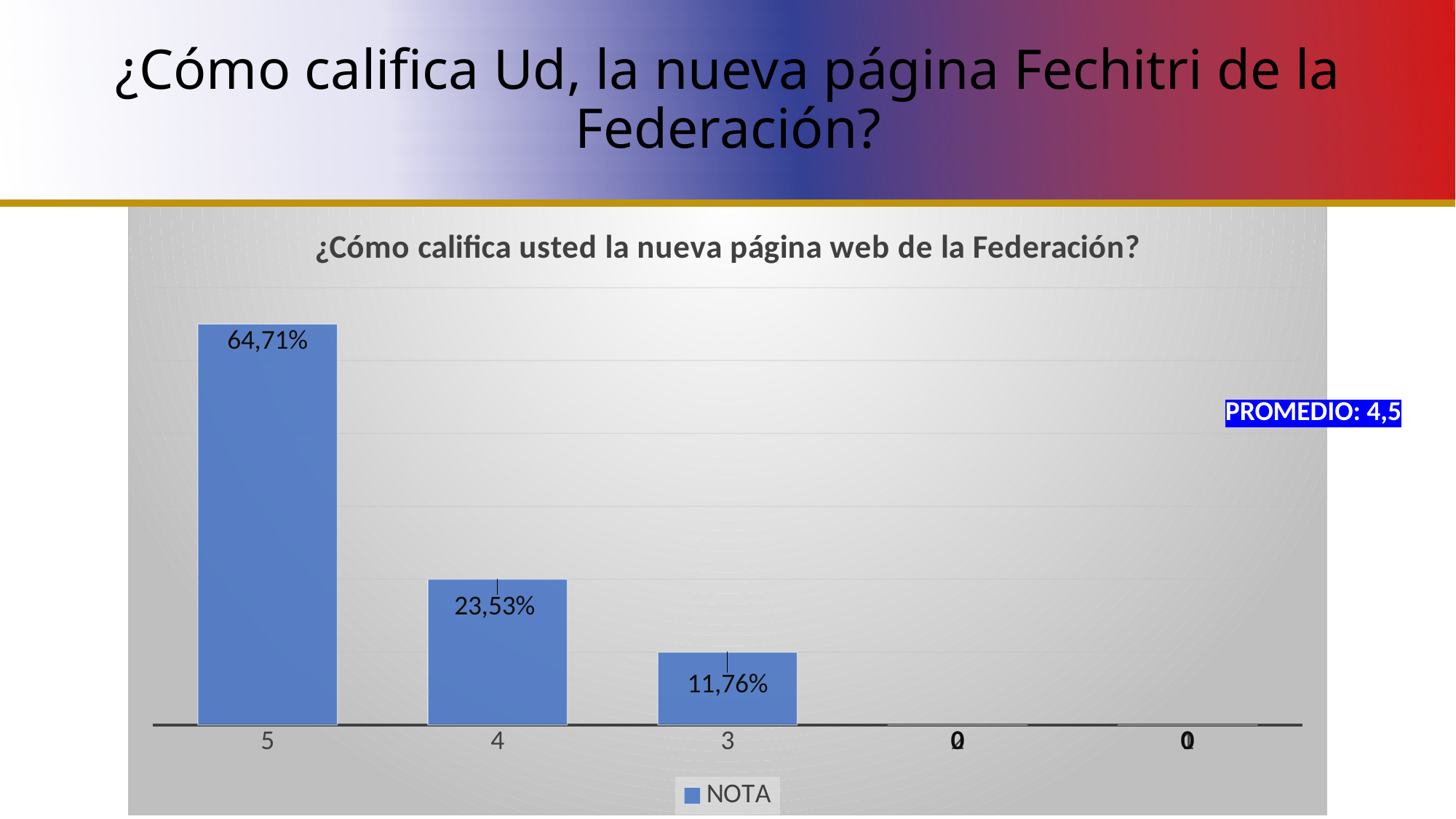
What percentage of respondents gave a rating of 4? 23,53% Which is larger, the percentage for rating 4 or for rating 3? rating 4 What kind of chart is shown on the slide? bar chart What is the difference between the percentages for rating 4 and rating 3? 11,77% Which rating category has the highest percentage? 5 What is the difference between the percentages for rating 5 and rating 4? 41,18% How many series does the legend list? 1 Do the bar values rise or fall moving from left to right along the x axis? fall How many rating categories are shown on the x axis? 5 What percentage of respondents gave a rating of 3? 11,76% What percentage of respondents gave a rating of 5? 64,71% What is the name of the series shown in the legend? NOTA